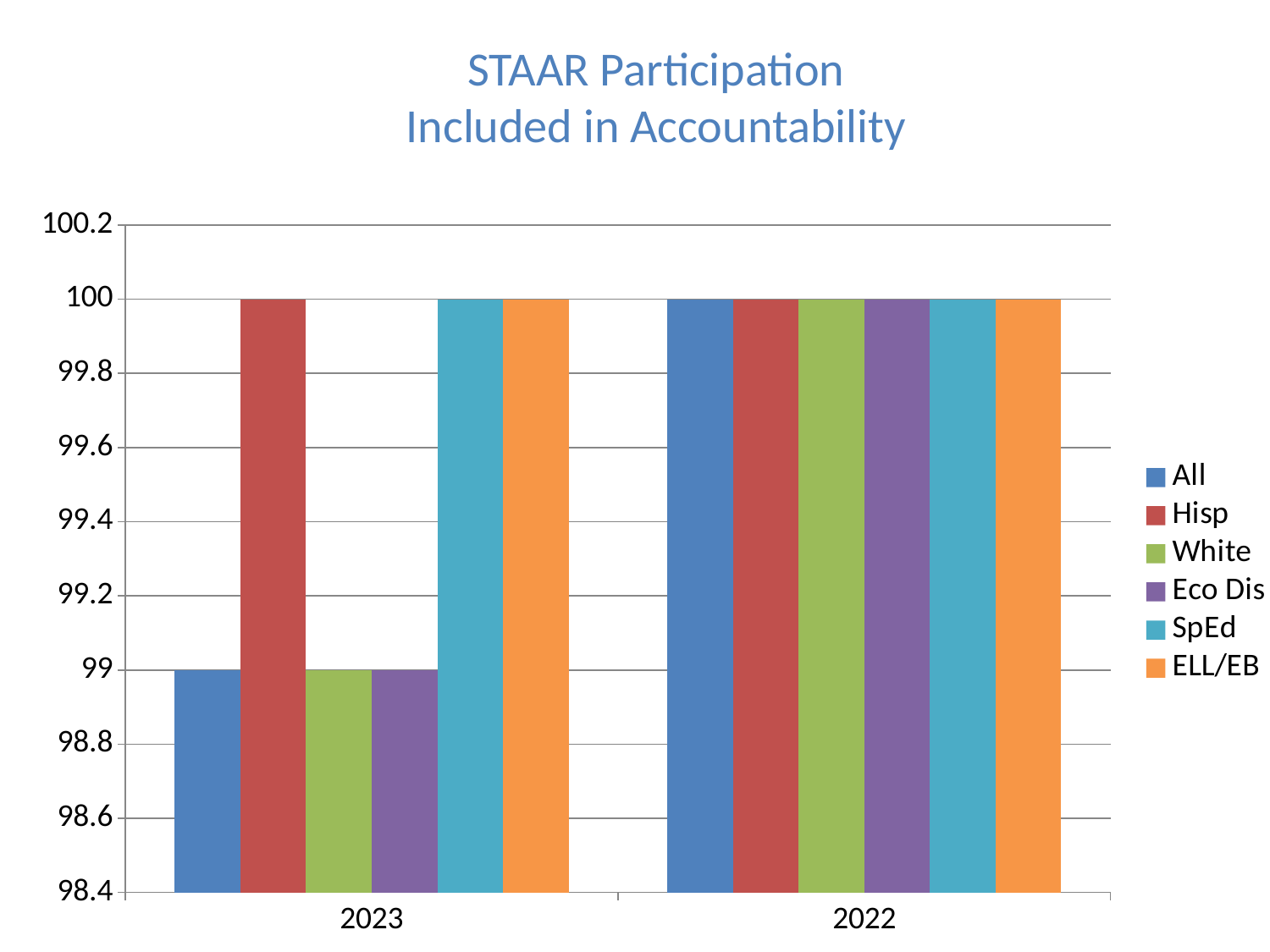
What is the value for Eco Dis in 2022? 100 What is the title of the chart? STAAR Participation Included in Accountability What is the difference between the SpEd value in 2023 and the All value in 2023? 1 What is the value for White in 2023? 99 Which is larger, the Eco Dis value in 2023 or the Eco Dis value in 2022? 2022 What is the value for Hisp in 2023? 100 Is the value for White in 2023 greater or less than 99.4? less How many categories are shown on the x axis? 2 Does the value for All rise or fall from 2023 to 2022 along the x axis? rise How many series does the legend list? 6 What kind of chart is shown on the slide? bar chart What is the value for All in 2023? 99